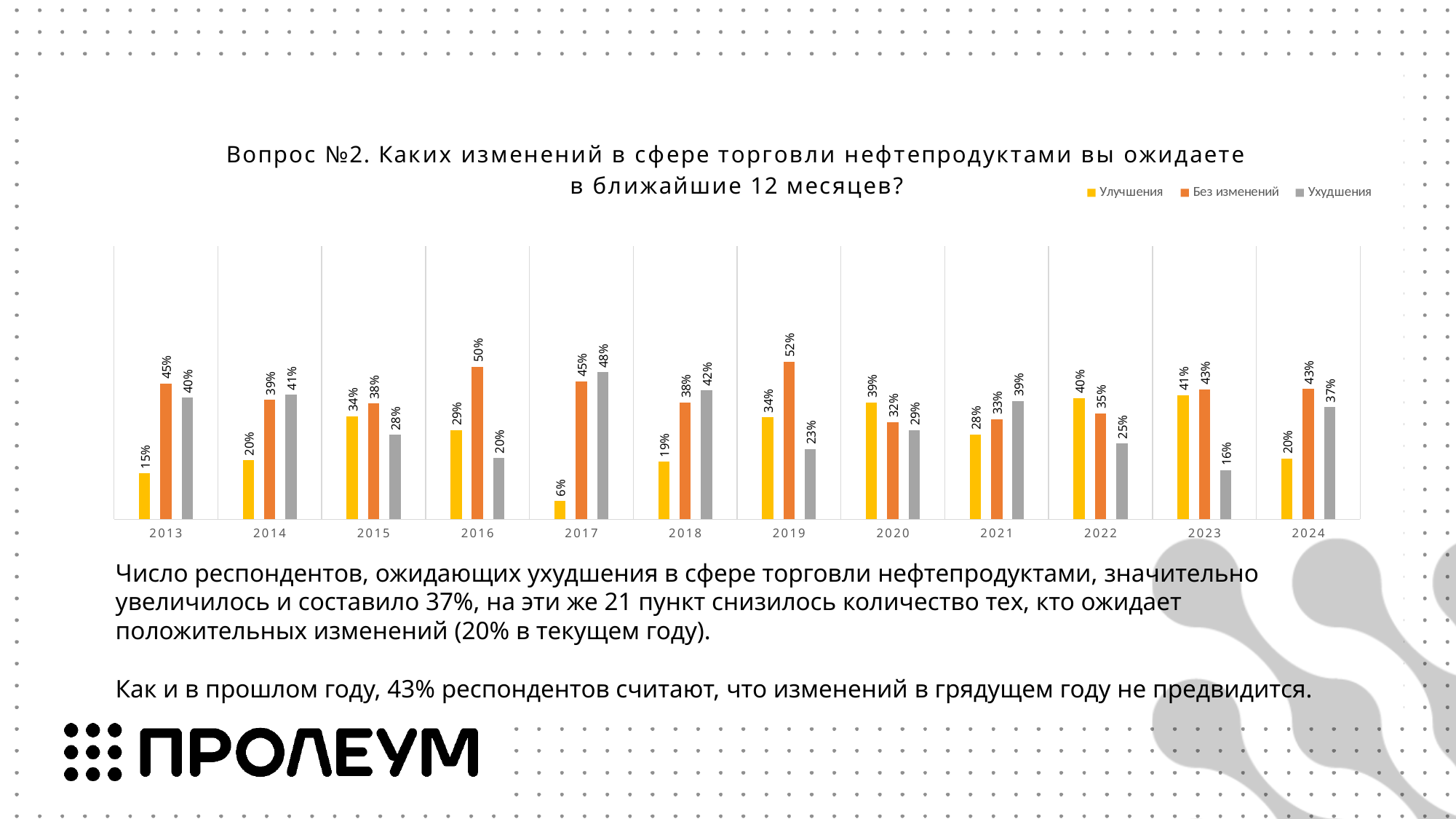
In which year does the "Без изменений" series reach its highest value? 2019 What kind of chart is shown on the slide? Bar chart Which colour represents the "Улучшения" series in the legend? Yellow In 2020, which is larger: "Улучшения" or "Ухудшения"? Улучшения What is the total of the three values shown for 2023? 100% How many series does the legend list? 3 What value is shown for "Улучшения" in 2017? 6% What value is shown for "Без изменений" in 2016? 50% What is the difference between the "Без изменений" and "Улучшения" values in 2024? 23% In which year is the "Улучшения" value the lowest? 2017 How many years are shown on the x axis? 12 What value is shown for "Ухудшения" in 2024? 37%